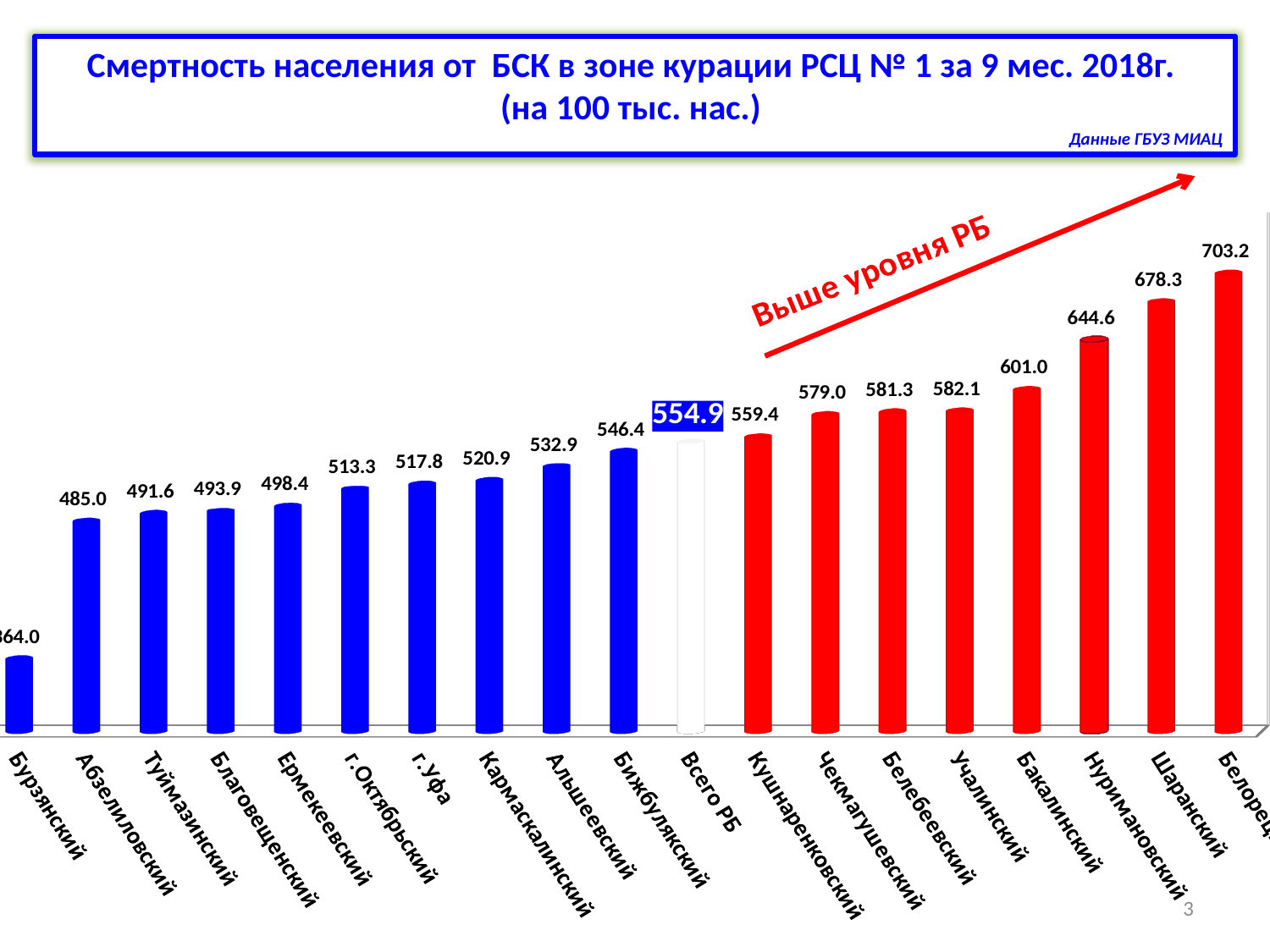
What is the value for Бакалинский? 601.0 How many bars are shown on the chart? 19 What is the value for г.Уфа? 517.8 What type of chart is shown on the slide? bar chart What is the value for Всего РБ? 554.9 What is the value for Абзелиловский? 485.0 Which category has the lowest value on the chart? Бурзянский What is the difference between the values for Шаранский and Нуримановский? 33.7 What is the value for Шаранский? 678.3 Which is larger, the value for Кушнаренковский or the value for Бижбулякский? Кушнаренковский What is the highest value shown on the chart? 703.2 Do the values rise or fall from left to right along the x axis? rise